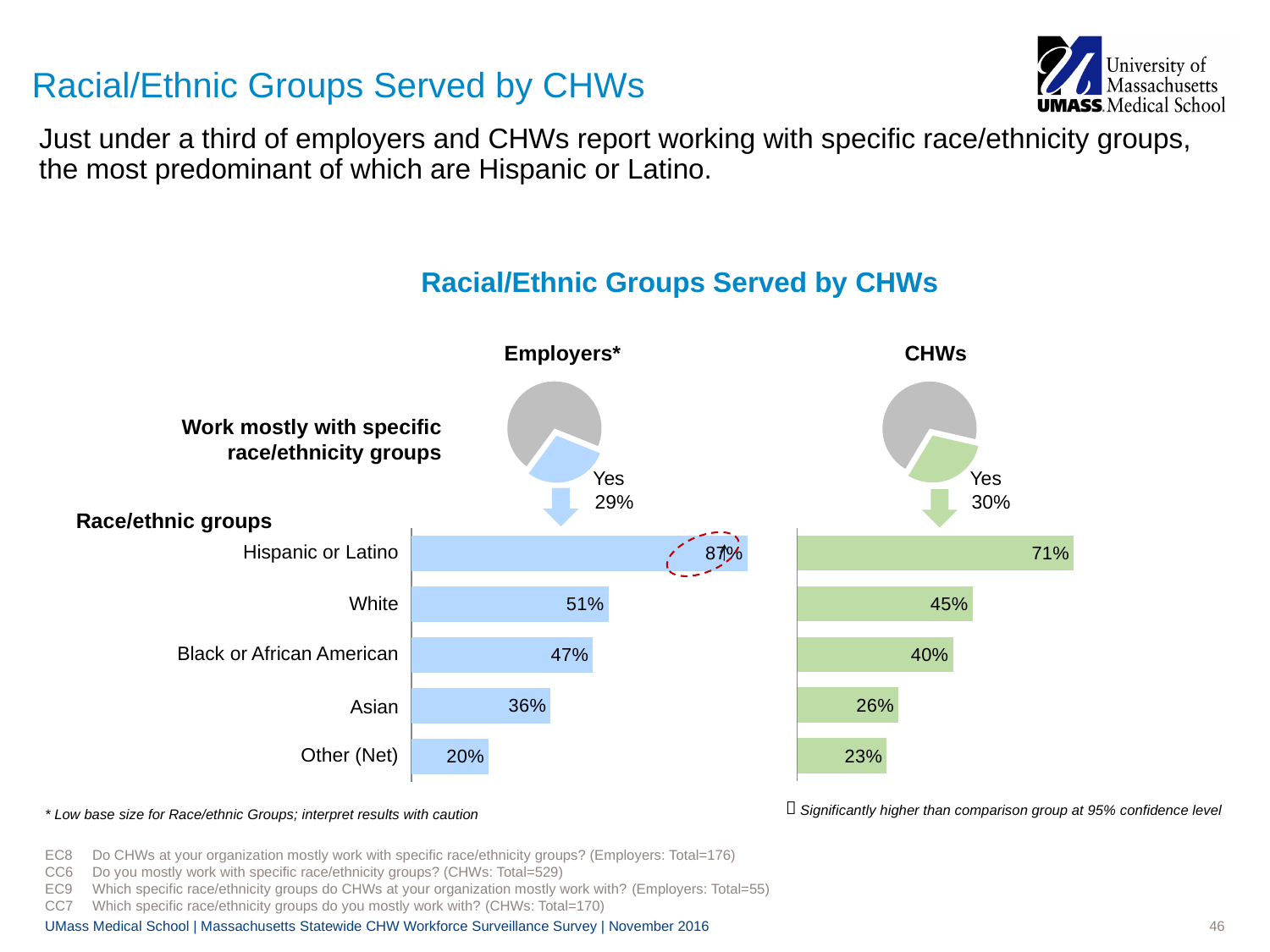
Which is larger: the Employers value for Asian or the CHWs value for Asian? Employers (36%) In the Employers bar chart, what is the difference between White and Asian? 15 percentage points In the CHWs bar chart, which race/ethnic group has the highest value? Hispanic or Latino In the CHWs pie chart, what share answered Yes to working mostly with specific race/ethnicity groups? 30% What is the difference between the Employers and CHWs values for Hispanic or Latino? 16 percentage points In the CHWs bar chart, what is the value for Black or African American? 40% In the CHWs bar chart, what is the value for Other (Net)? 23% How many race/ethnic groups are listed in the bar charts? 5 What type of chart is used to show the race/ethnic groups served? Bar chart In the Employers bar chart, which race/ethnic group has the lowest value? Other (Net) In the Employers pie chart, what share answered Yes to working mostly with specific race/ethnicity groups? 29% In the Employers bar chart, what is the value for Hispanic or Latino? 87%